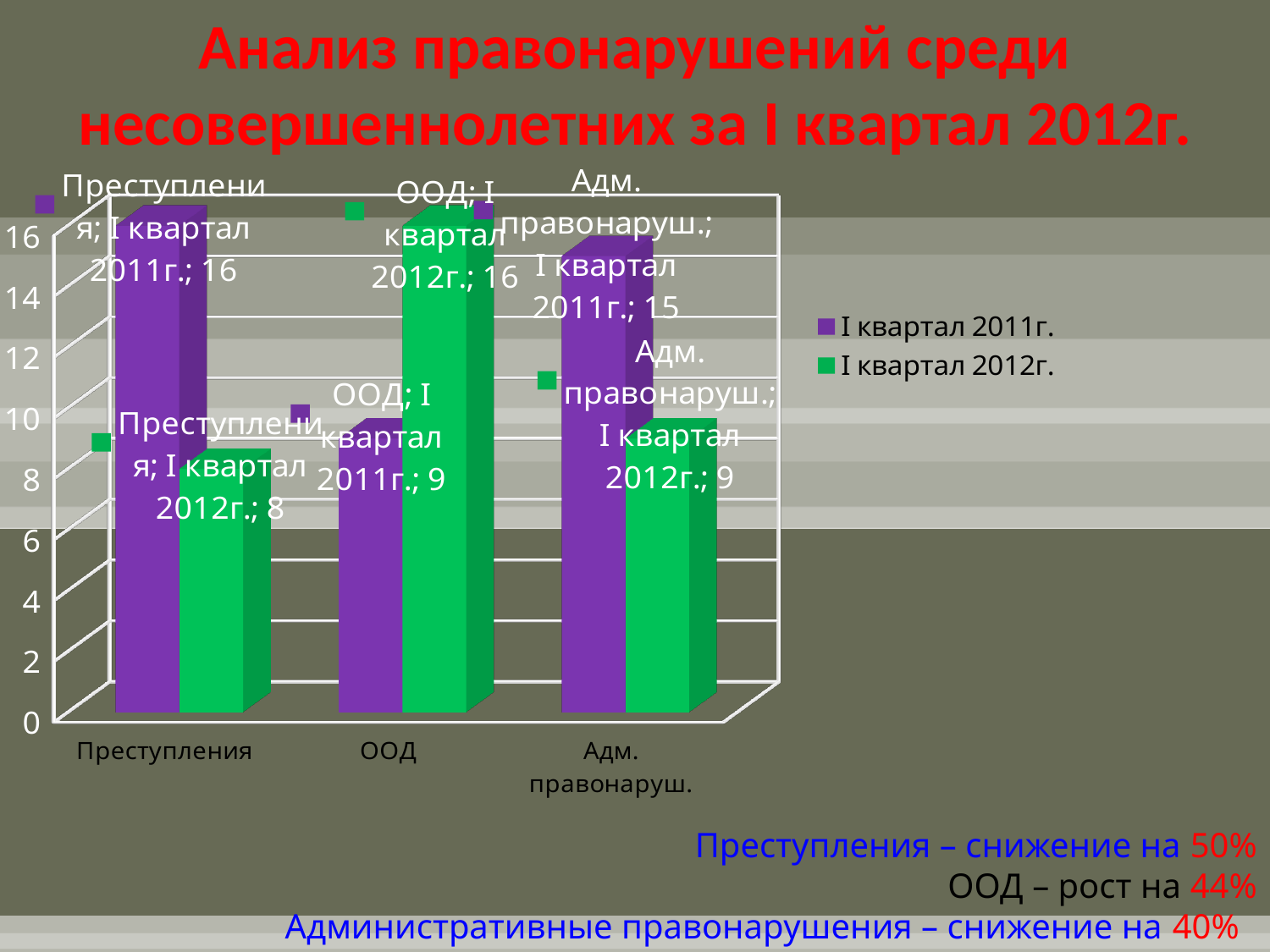
What is the difference between the I квартал 2011г. and I квартал 2012г. values for Преступления? 8 Which category has the lowest value in the I квартал 2011г. series? ООД How many categories are shown on the x axis? 3 What is the value for ООД in the I квартал 2012г. series? 16 What is the value for Адм. правонаруш. in the I квартал 2011г. series? 15 Which is larger for ООД: the I квартал 2011г. value or the I квартал 2012г. value? I квартал 2012г. Which colour represents the I квартал 2012г. series? Green What is the value for Преступления in the I квартал 2012г. series? 8 What is the value for Преступления in the I квартал 2011г. series? 16 Which category has the lowest value in the I квартал 2012г. series? Преступления What kind of chart is shown on the slide? Bar chart How many series does the legend list? 2